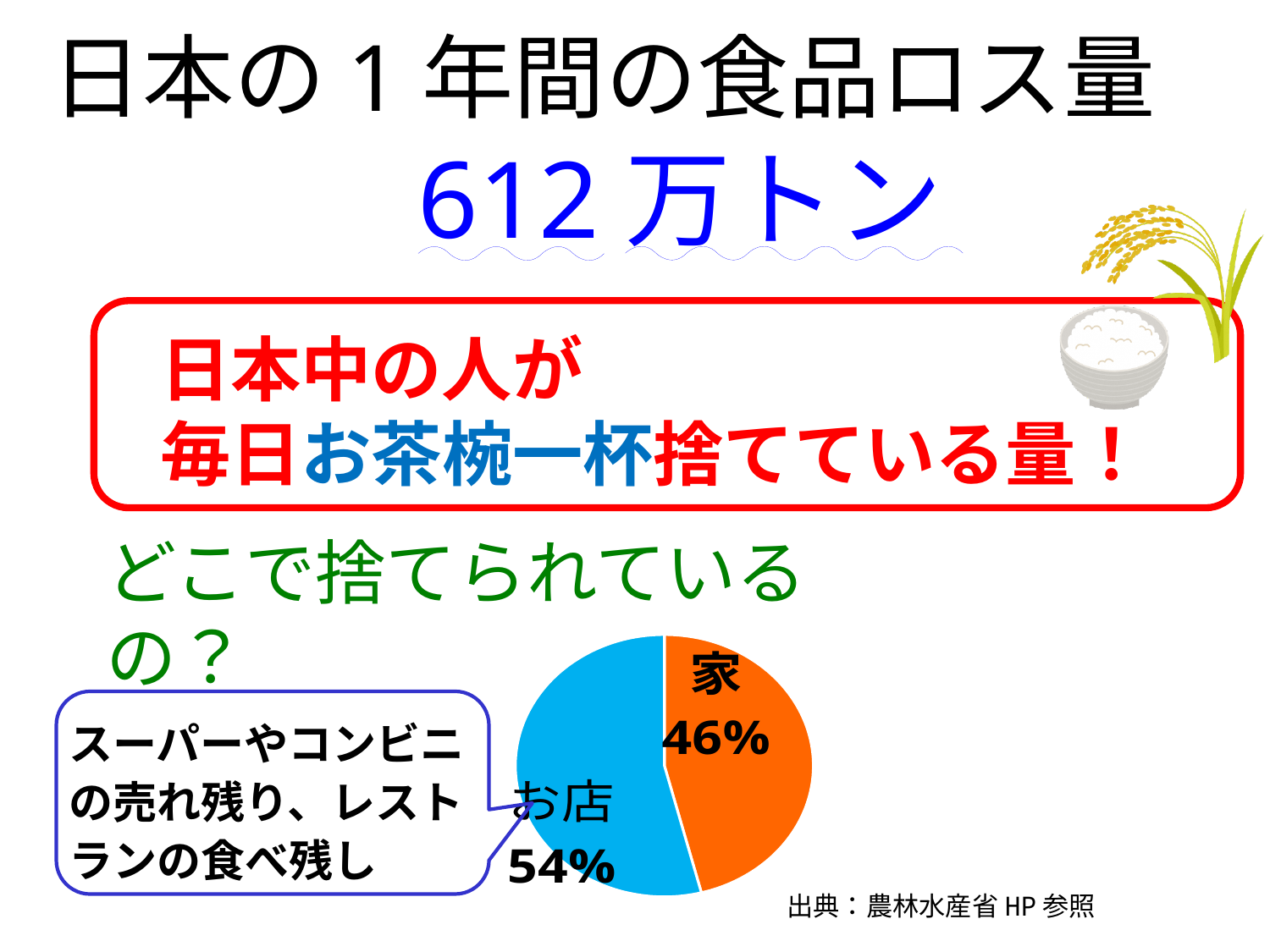
What colour is the お店 slice of the pie chart? blue What kind of chart is shown on the slide? pie chart Which slice of the pie chart is the largest? お店 Is the share for 家 greater or less than 50%? less What colour is the 家 slice of the pie chart? orange What share of the pie chart is labelled お店? 54% What share of the pie chart is labelled 家? 46% How many slices does the pie chart have? 2 Which slice of the pie chart is the smallest? 家 Which is larger in the pie chart, 家 or お店? お店 What is the difference in percentage points between the お店 slice and the 家 slice? 8%